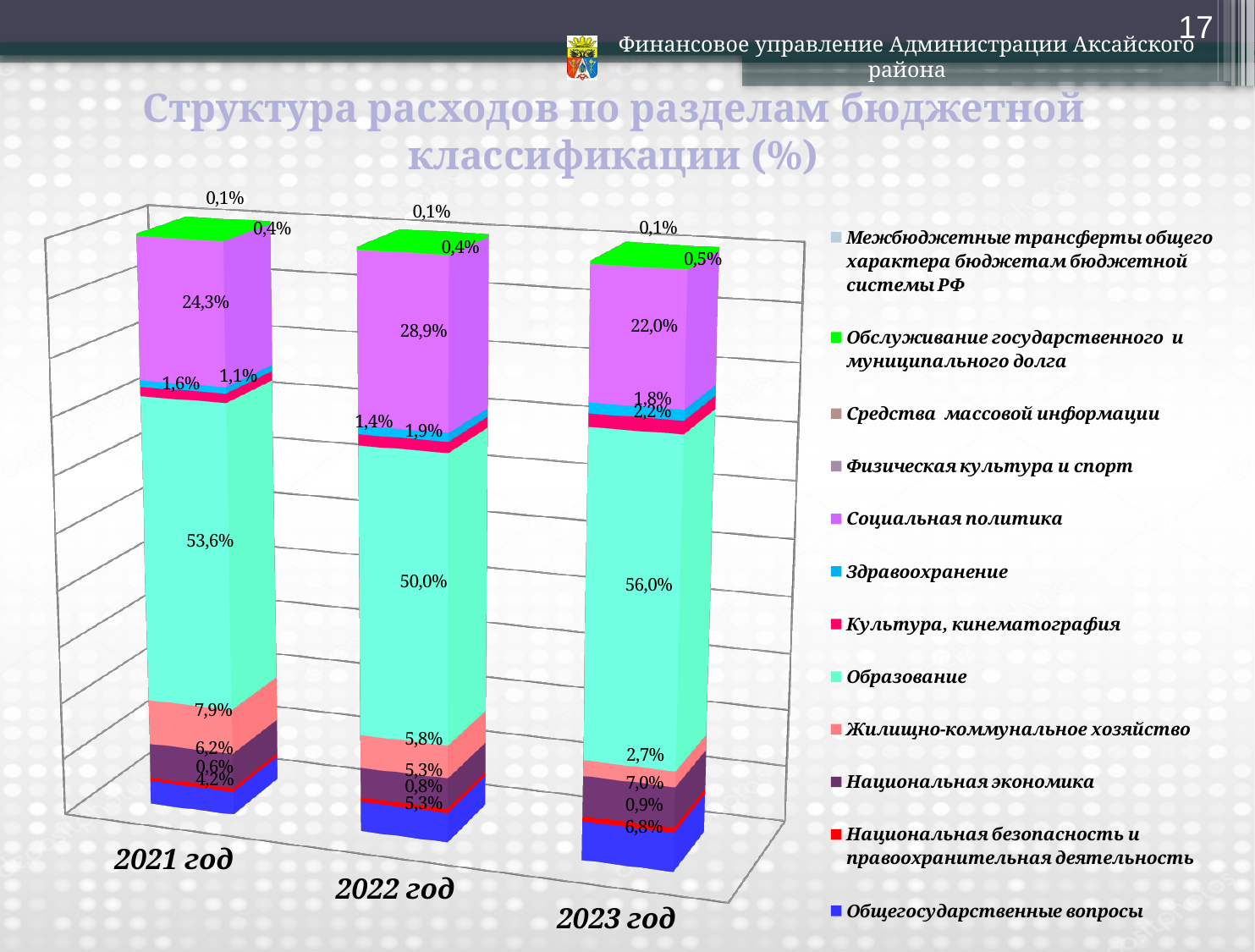
What is the share of Жилищно-коммунальное хозяйство in 2023? 2,7% Does the share of Жилищно-коммунальное хозяйство rise or fall from 2021 to 2023? Falls How many years (bars) are shown in the chart? 3 What is the share of Образование in 2021? 53,6% In which year is the share of Образование the highest? 2023 год How many series does the legend list? 12 By how many percentage points does the share of Образование in 2023 exceed that in 2022? 6,0 What is the share of Общегосударственные вопросы in 2023? 6,8% What type of chart is shown on the slide? Stacked bar chart What is the share of Национальная экономика in 2022? 5,3% What is the share of Социальная политика in 2022? 28,9% Which year has the larger share of Социальная политика, 2021 or 2022? 2022 год